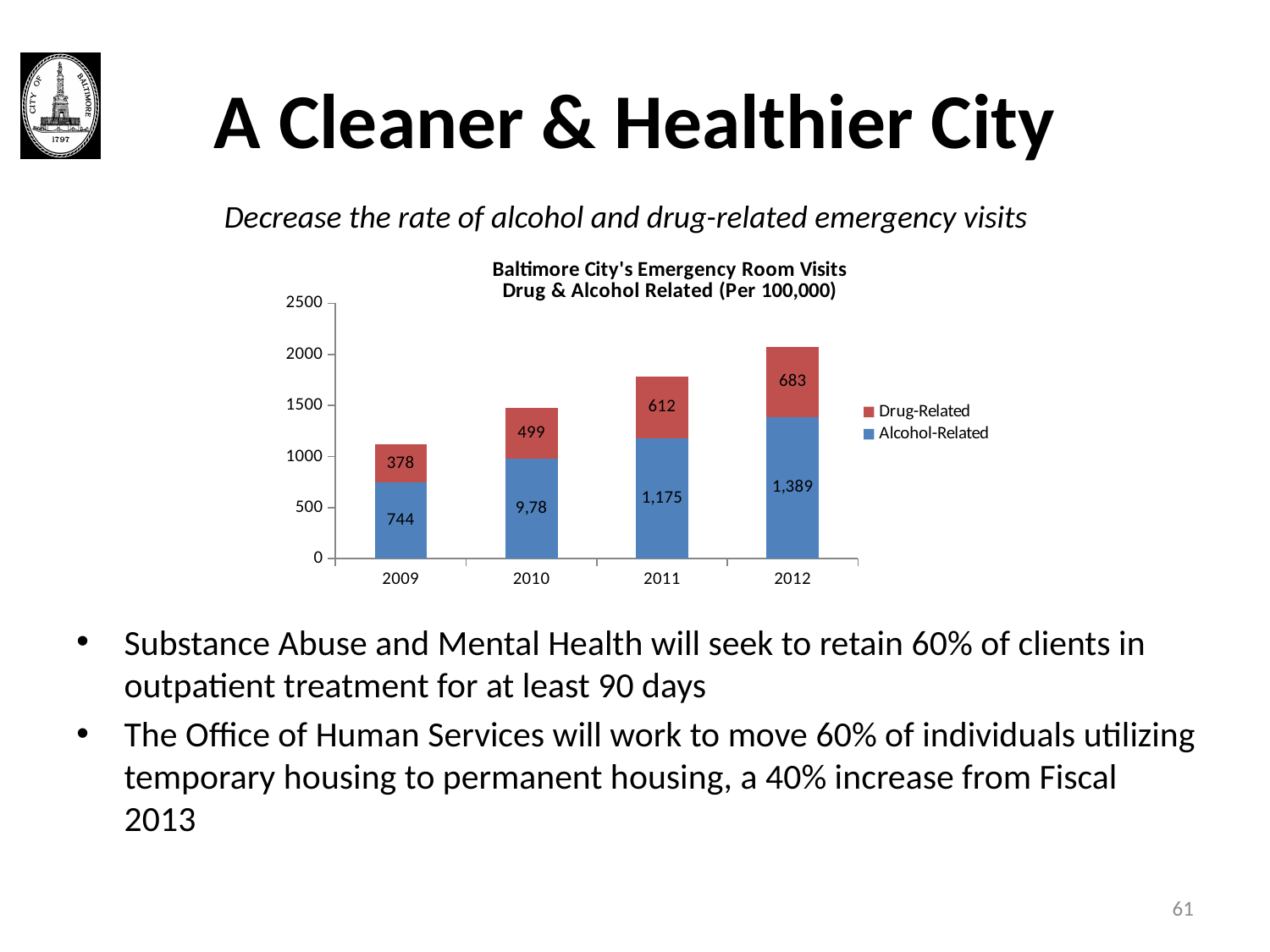
How many years are shown on the x axis? 4 What is the Drug-Related value for 2011? 612 In which year is the Drug-Related value highest? 2012 What is the total of the stacked bar for 2009? 1,122 In which year is the Alcohol-Related value lowest? 2009 What is the difference between the Drug-Related values for 2012 and 2009? 305 What is the difference between the Alcohol-Related values for 2012 and 2011? 214 How many series does the legend list? 2 Is the total height of the 2012 stacked bar greater or less than 2000? greater What is the Drug-Related value for 2009? 378 What is the Alcohol-Related value for 2012? 1,389 In 2011, which is larger, the Alcohol-Related value or the Drug-Related value? Alcohol-Related